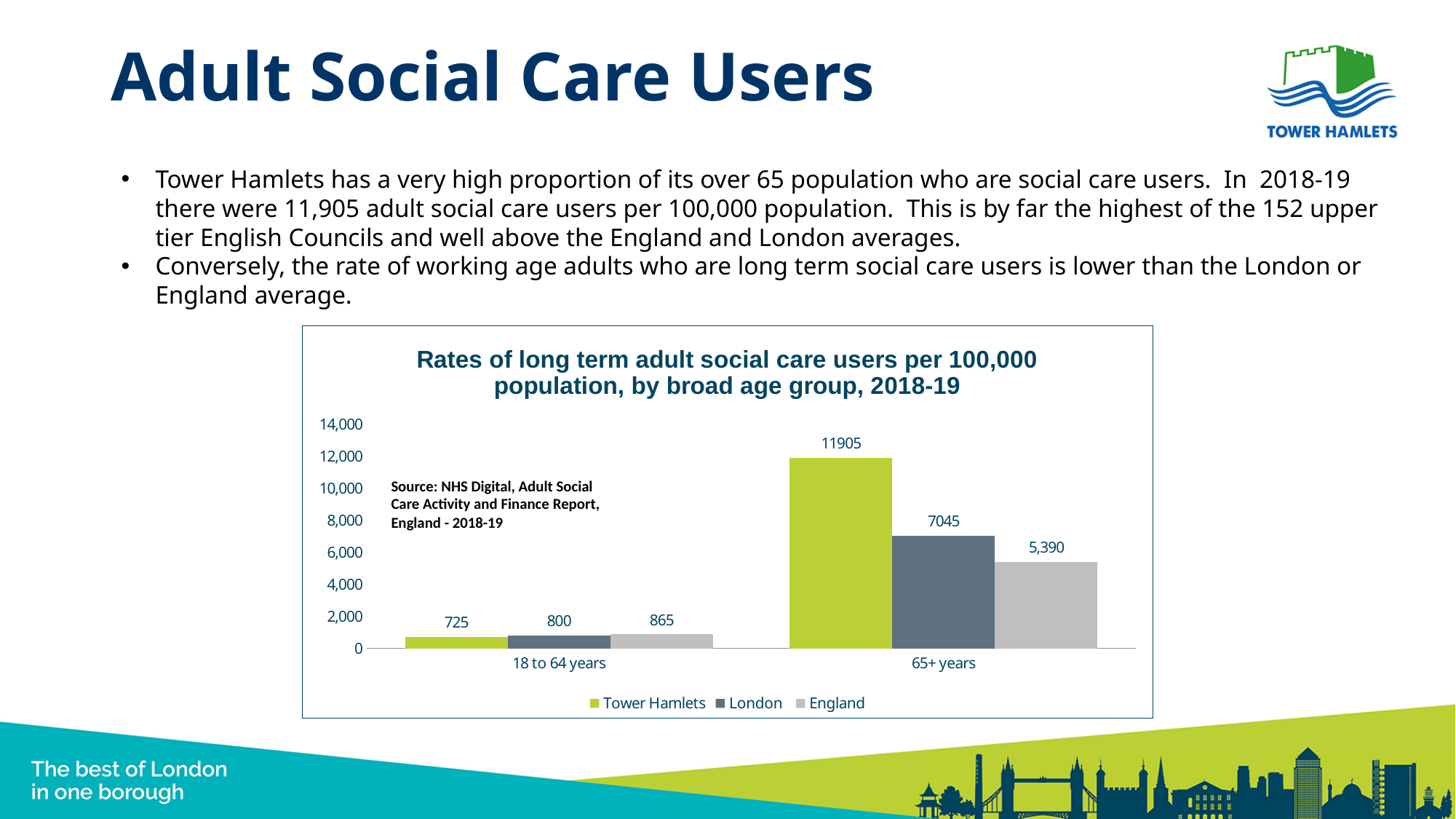
What kind of chart is shown on the slide? Bar chart What is the difference between the Tower Hamlets and London values in the 65+ years age group? 4860 Which series has the lowest value in the 18 to 64 years age group? Tower Hamlets In the 18 to 64 years age group, which is larger: the value for England or the value for Tower Hamlets? England What is the value for London in the 18 to 64 years age group? 800 How many age group categories are shown on the x axis? 2 How many series does the legend list? 3 Is the value for London in the 65+ years age group greater or less than 6,000? greater What is the value for Tower Hamlets in the 18 to 64 years age group? 725 What is the value for England in the 65+ years age group? 5,390 What is the rate of long term adult social care users per 100,000 population for Tower Hamlets in the 65+ years age group? 11905 Which series has the highest value in the 65+ years age group? Tower Hamlets